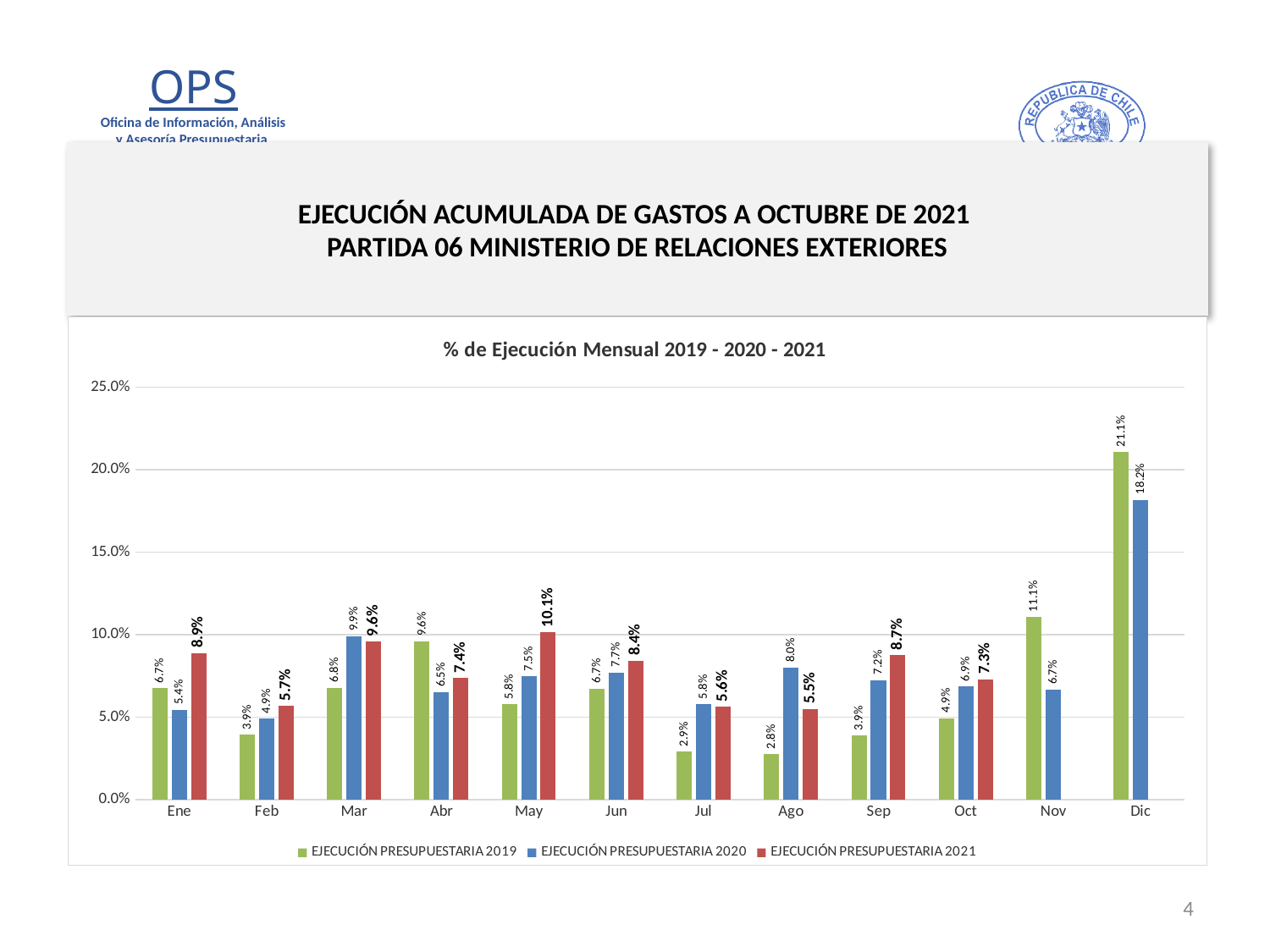
Which month has the lowest value for EJECUCIÓN PRESUPUESTARIA 2019? Ago What is the value for EJECUCIÓN PRESUPUESTARIA 2021 in May? 10.1% How many months are shown on the x axis? 12 Is the value for EJECUCIÓN PRESUPUESTARIA 2020 in Dic greater or less than 15.0%? greater What is the difference between the EJECUCIÓN PRESUPUESTARIA 2019 and EJECUCIÓN PRESUPUESTARIA 2020 values in Dic? 2.9% What kind of chart is shown on the slide? Bar chart What is the value for EJECUCIÓN PRESUPUESTARIA 2019 in Dic? 21.1% What is the title of the chart? % de Ejecución Mensual 2019 - 2020 - 2021 Which is larger in Mar: EJECUCIÓN PRESUPUESTARIA 2020 or EJECUCIÓN PRESUPUESTARIA 2021? EJECUCIÓN PRESUPUESTARIA 2020 Which month has the highest value for EJECUCIÓN PRESUPUESTARIA 2021? May How many series does the legend list? 3 What is the value for EJECUCIÓN PRESUPUESTARIA 2020 in Ago? 8.0%